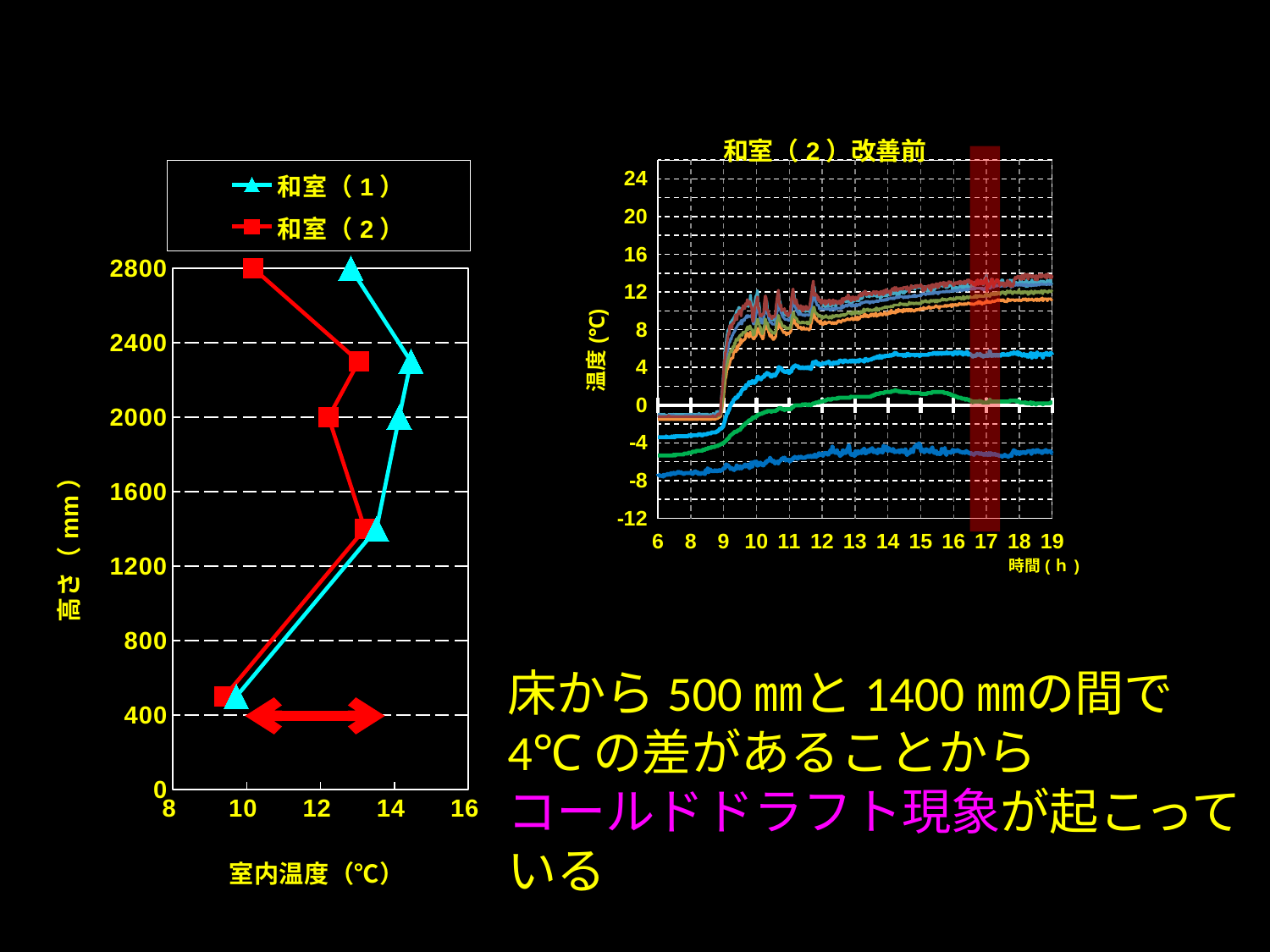
On the left chart, at a height of 2800 mm, which series has the higher 室内温度: 和室（1）or 和室（2）? 和室（1） What is the title of the chart on the right? 和室（2）改善前 On the left chart, how many data points does the 和室（1）series have? 5 On the left chart, how many series does the legend list? 2 On the left chart, at a height of 2000 mm, which series has the higher 室内温度: 和室（1）or 和室（2）? 和室（1） On the left chart, is the 室内温度 value for 和室（1）at a height of 500 mm greater or less than 12? less On the right chart 和室（2）改善前, what kind of chart is shown? line chart On the left chart, what is the title of the horizontal axis? 室内温度（℃） On the left chart, is the 室内温度 value for 和室（1）at a height of 2800 mm greater or less than 12? greater On the right chart 和室（2）改善前, is the value of the green line at 19 h greater or less than 4? less On the left chart, what kind of chart is shown? line chart